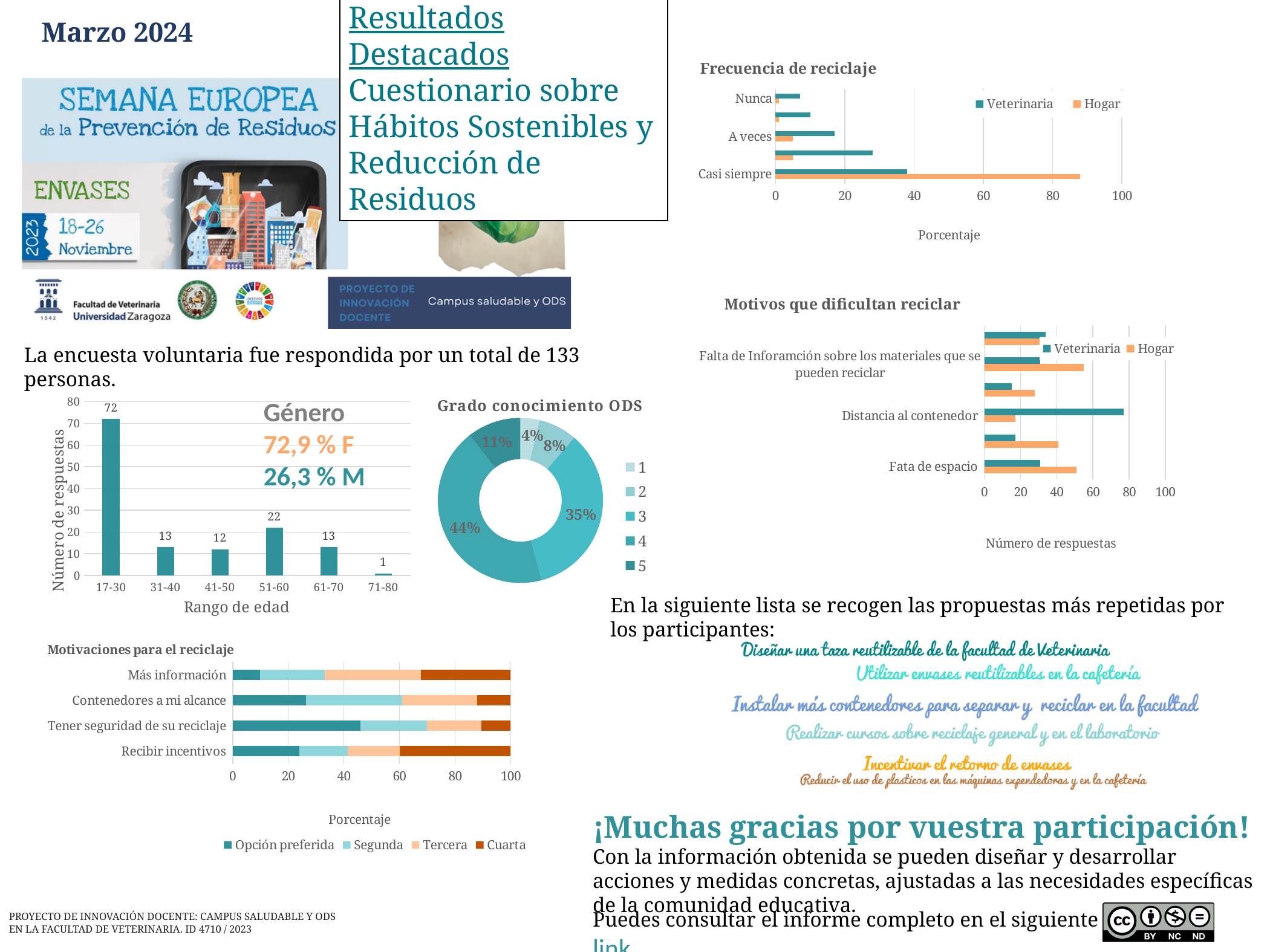
In the 'Rango de edad' bar chart, what is the difference in responses between the 17-30 and 51-60 age ranges? 50 In the 'Frecuencia de reciclaje' chart, which series has the larger value for 'Casi siempre', Veterinaria or Hogar? Hogar In the 'Rango de edad' bar chart, how many age ranges are shown? 6 In the 'Grado conocimiento ODS' donut chart, what share does level 4 have? 44% In the 'Grado conocimiento ODS' donut chart, what is the combined share of levels 3 and 4? 79% In the 'Rango de edad' bar chart, how many responses are there for the 51-60 age range? 22 How many series does the legend of the 'Motivaciones para el reciclaje' chart list? 4 In the 'Frecuencia de reciclaje' chart, is the Hogar value for 'Casi siempre' greater or less than 80? greater In the 'Grado conocimiento ODS' donut chart, which level has the smallest share? 1 In the 'Rango de edad' bar chart, how many responses are there for the 17-30 age range? 72 In the 'Motivos que dificultan reciclar' chart, is the Veterinaria value for 'Distancia al contenedor' greater or less than 60? greater In the 'Rango de edad' bar chart, which age range has the fewest responses? 71-80